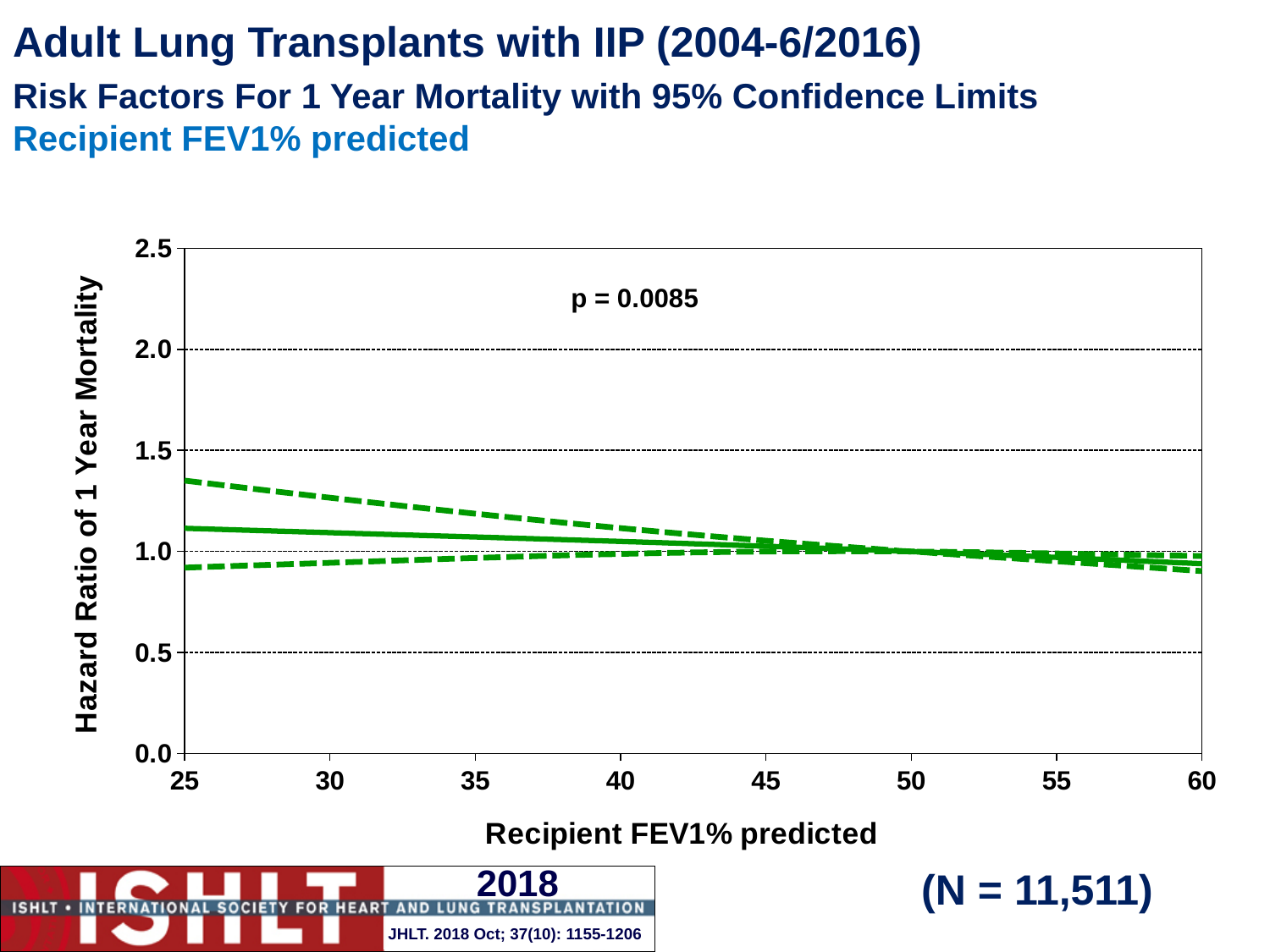
What p-value is printed on the chart? p = 0.0085 Does the solid hazard ratio line rise or fall as Recipient FEV1% predicted increases from 25 to 60? fall What kind of chart is shown on the slide? line chart Is the upper 95% confidence limit (upper dashed line) at Recipient FEV1% predicted of 25 greater or less than 1.5? less What is the label of the y axis? Hazard Ratio of 1 Year Mortality How many lines are plotted on the chart? 3 Is the lower 95% confidence limit (lower dashed line) at Recipient FEV1% predicted of 25 greater or less than 1.0? less Is the hazard ratio (solid line) at Recipient FEV1% predicted of 25 greater or less than 1.0? greater How many tick labels are shown on the x axis? 8